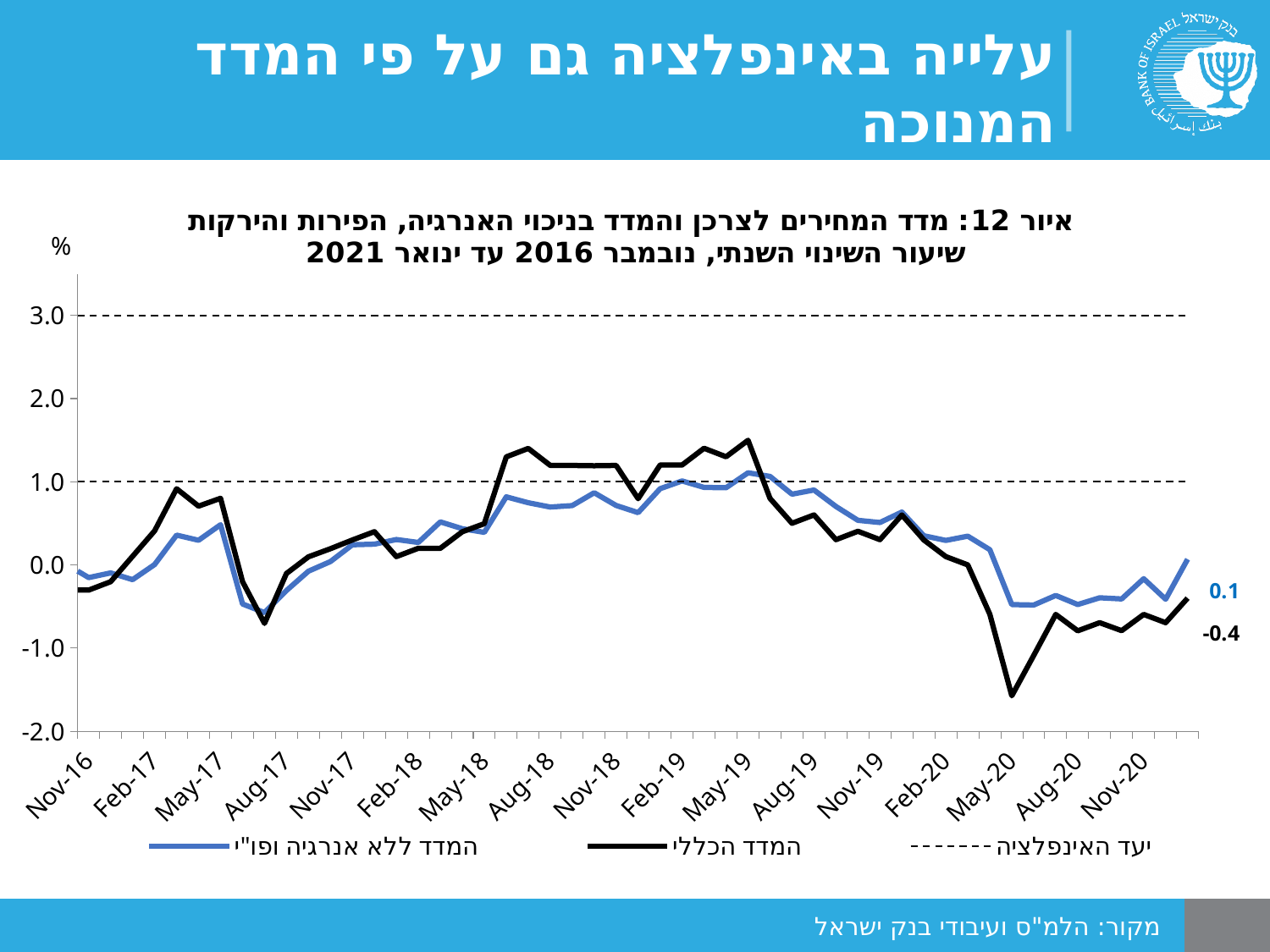
What kind of chart is shown on the slide? Line chart Is the value of המדד הכללי at May-19 greater or less than 1.0? greater Is the value of המדד ללא אנרגיה ופו"י at Aug-20 greater or less than 0.0? less What is the final data label shown for the black line (המדד הכללי)? -0.4 How many entries does the legend list? 3 Which line reaches the lowest point on the chart: המדד הכללי or המדד ללא אנרגיה ופו"י? המדד הכללי Which line reaches the highest point on the chart: המדד הכללי or המדד ללא אנרגיה ופו"י? המדד הכללי What is the difference between the final labelled values of the two lines (0.1 and -0.4)? 0.5 At the end of the series, which line has the higher value: המדד הכללי or המדד ללא אנרגיה ופו"י? המדד ללא אנרגיה ופו"י What is the final data label shown for the blue line (המדד ללא אנרגיה ופו"י)? 0.1 At what two values are the dashed inflation target (יעד האינפלציה) lines drawn? 1.0 and 3.0 Is the value of המדד הכללי at May-20 greater or less than -1.0? less